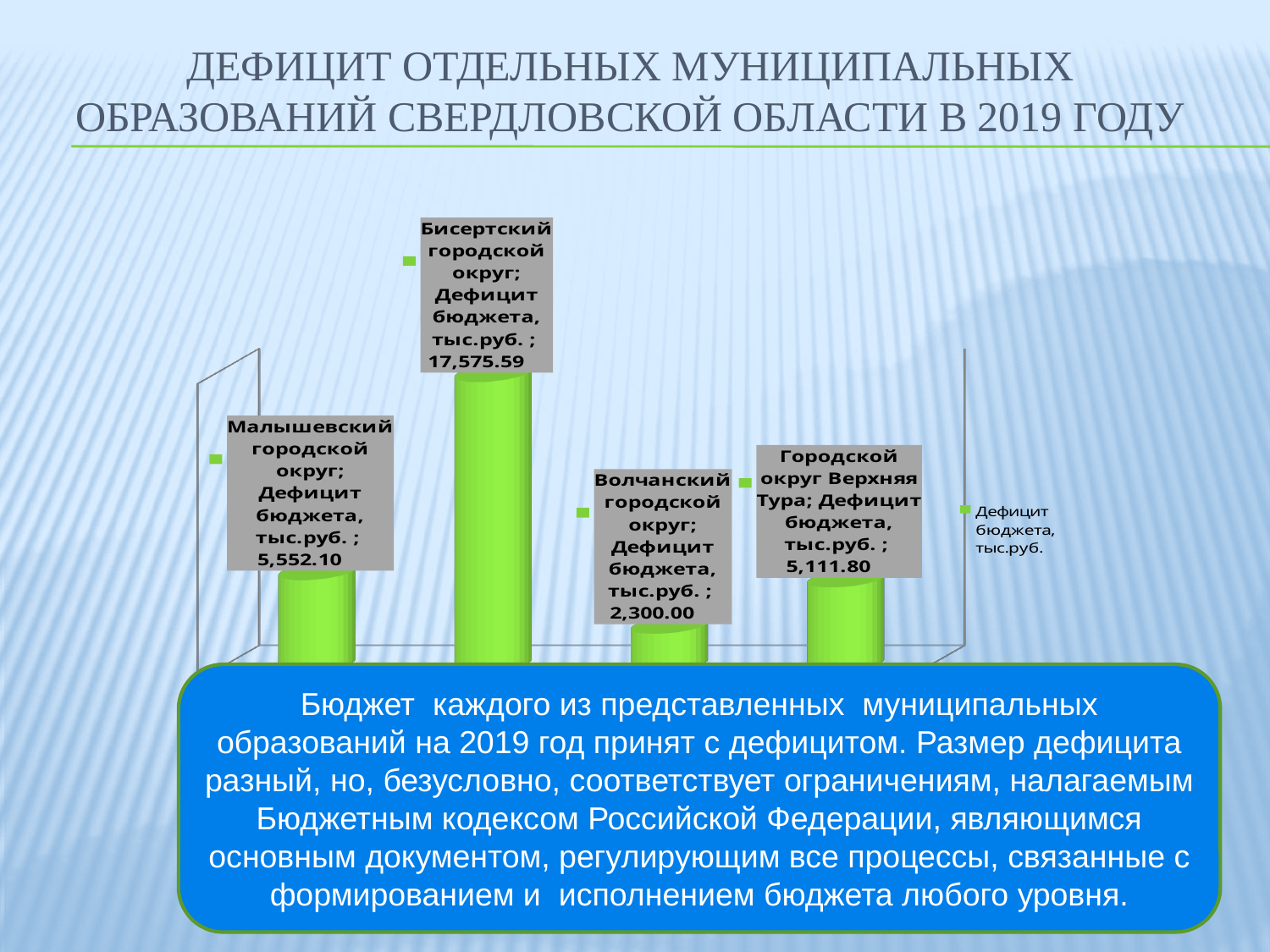
How many series does the chart legend list? 1 What is the difference between the budget deficit of Малышевский городской округ and Городской округ Верхняя Тура? 440.30 What is the budget deficit value shown for Городской округ Верхняя Тура? 5,111.80 What type of chart is shown on the slide? Bar chart Which municipality has the highest budget deficit on the chart? Бисертский городской округ What is the budget deficit value shown for Малышевский городской округ? 5,552.10 What is the budget deficit value shown for Бисертский городской округ? 17,575.59 Which has a larger budget deficit: Малышевский городской округ or Городской округ Верхняя Тура? Малышевский городской округ What is the difference between the budget deficit of Бисертский городской округ and Волчанский городской округ? 15,275.59 What is the budget deficit value shown for Волчанский городской округ? 2,300.00 How many municipalities are shown on the chart? 4 Which municipality has the lowest budget deficit on the chart? Волчанский городской округ